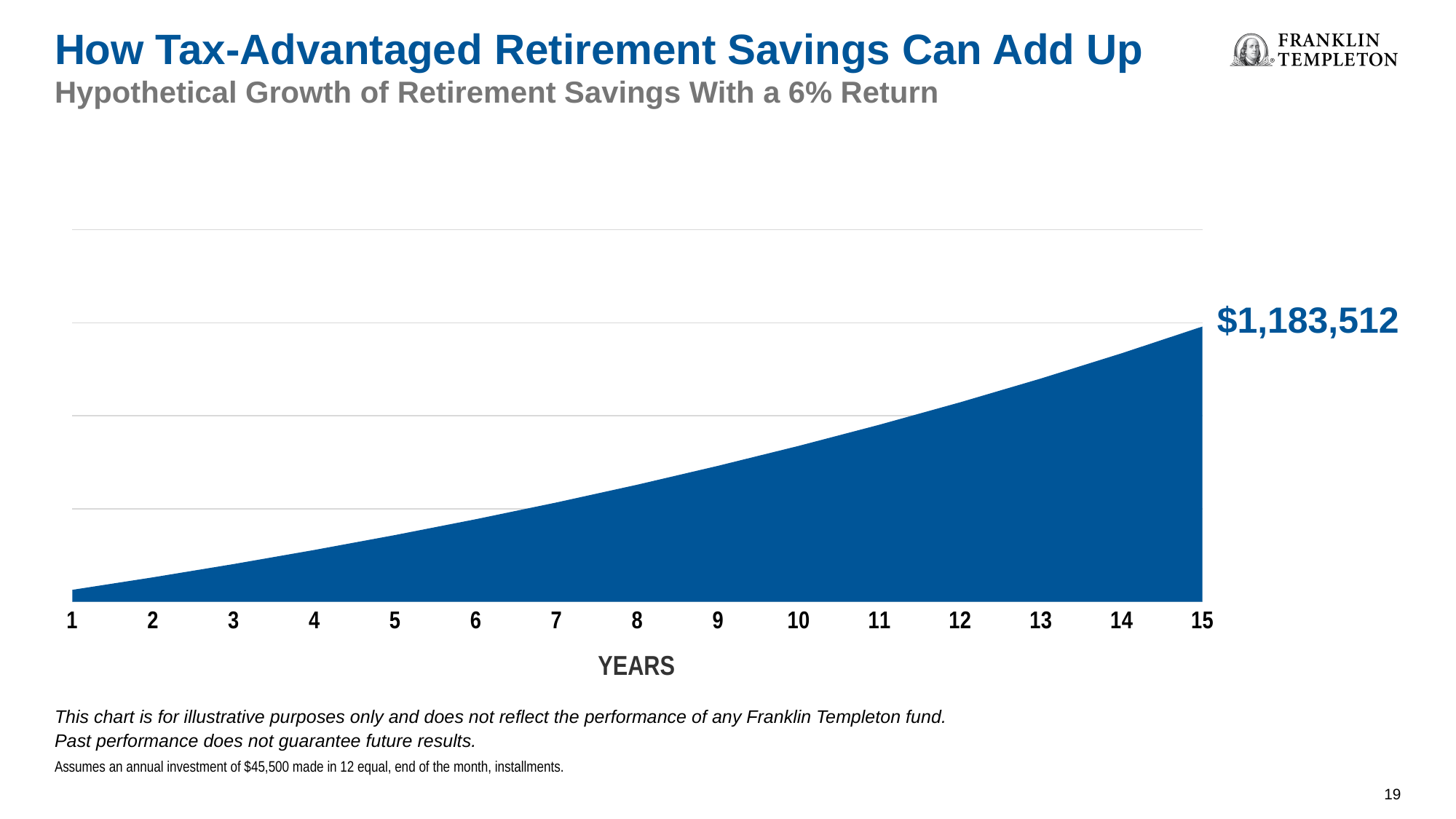
Do the values rise or fall as the years increase along the x axis? Rise What is the label on the x axis? YEARS What is the subtitle of the chart? Hypothetical Growth of Retirement Savings With a 6% Return What kind of chart is shown on the slide? Area chart What is the value shown at year 15? $1,183,512 How many years are shown along the x axis? 15 Which year has the lowest value? 1 Which is larger, the value at year 12 or the value at year 3? Year 12 Which year has the highest value? 15 Which is larger, the value at year 5 or the value at year 10? Year 10